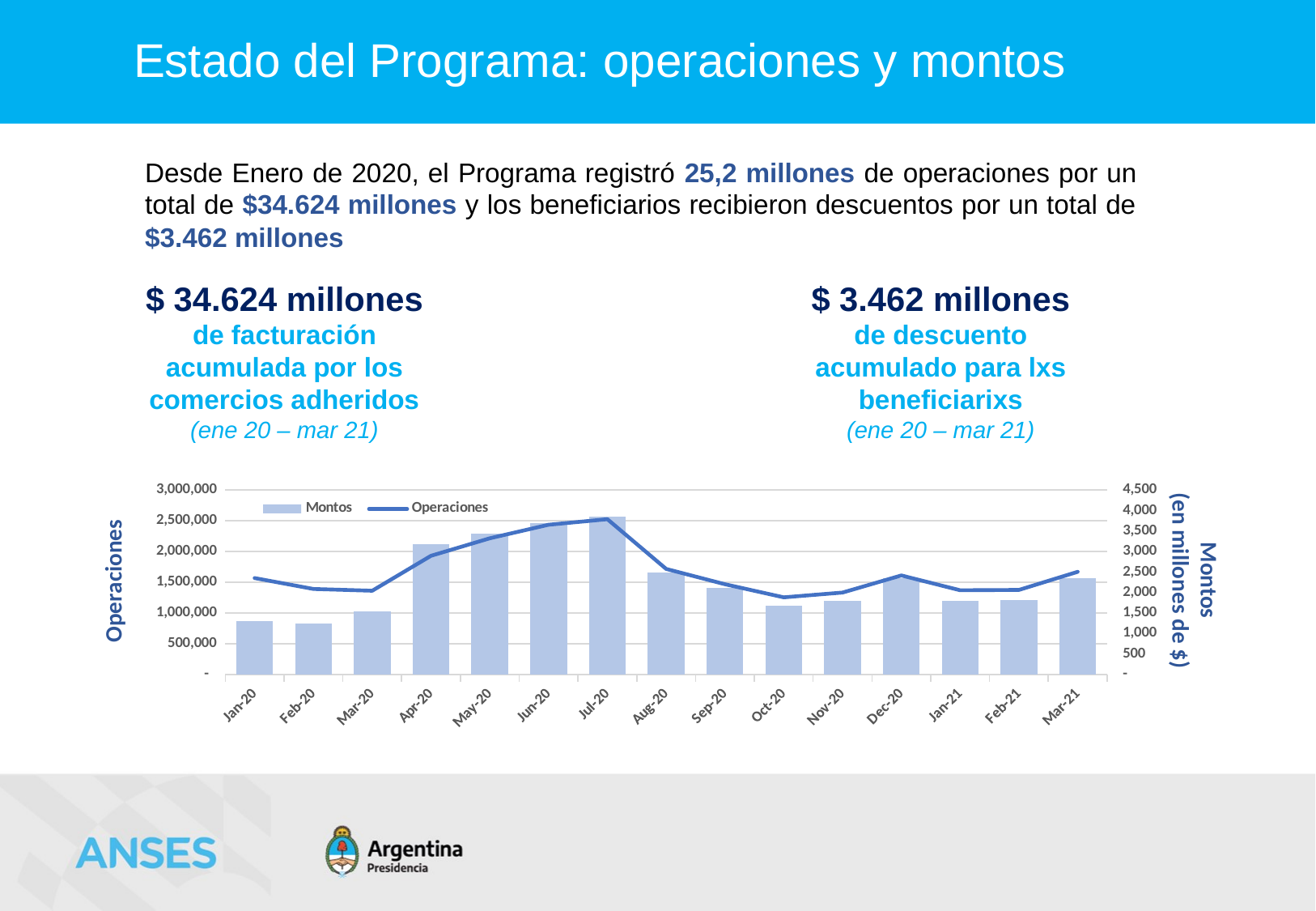
How many months are plotted along the x axis of the chart? 15 In which month does the Operaciones line reach its highest value? Jul-20 Is the Montos value for Jan-20 greater or less than 1,500? less Is the Montos value for Jul-20 greater or less than 3,500? greater Is the Operaciones value for Oct-20 greater or less than 1,500,000? less How many series does the chart legend list? 2 In which month do the Montos bars reach their highest value? Jul-20 In which month does the Operaciones line reach its lowest value? Oct-20 Do the Montos bars rise or fall from Jan-20 to Jul-20? Rise Which month has the larger Montos bar, Jun-20 or Dec-20? Jun-20 What kind of chart is shown on the slide? A combination bar and line chart What are the two series named in the chart legend? Montos and Operaciones